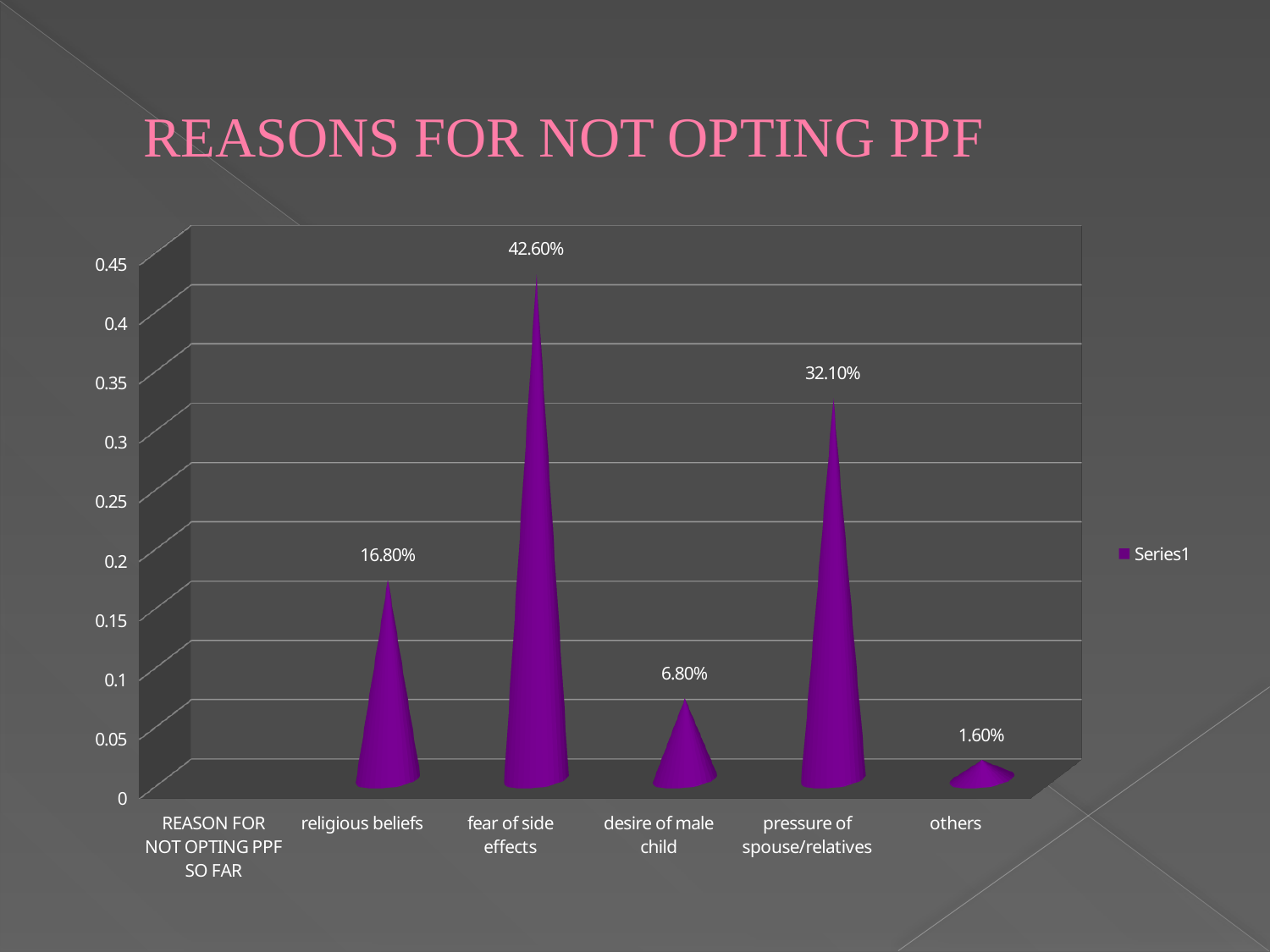
Is the value for religious beliefs greater or less than 0.2 on the axis? less How many series does the legend list? 1 Which is larger, the value for religious beliefs or the value for desire of male child? religious beliefs What is the value for others? 1.60% Which reason has the lowest value? others What is the value for religious beliefs? 16.80% Which reason has the highest value? fear of side effects What is the difference between the values for fear of side effects and pressure of spouse/relatives? 10.50% How many reasons have a plotted bar in the chart? 5 What kind of chart is shown on the slide? bar chart What is the value for fear of side effects? 42.60% What is the value for pressure of spouse/relatives? 32.10%